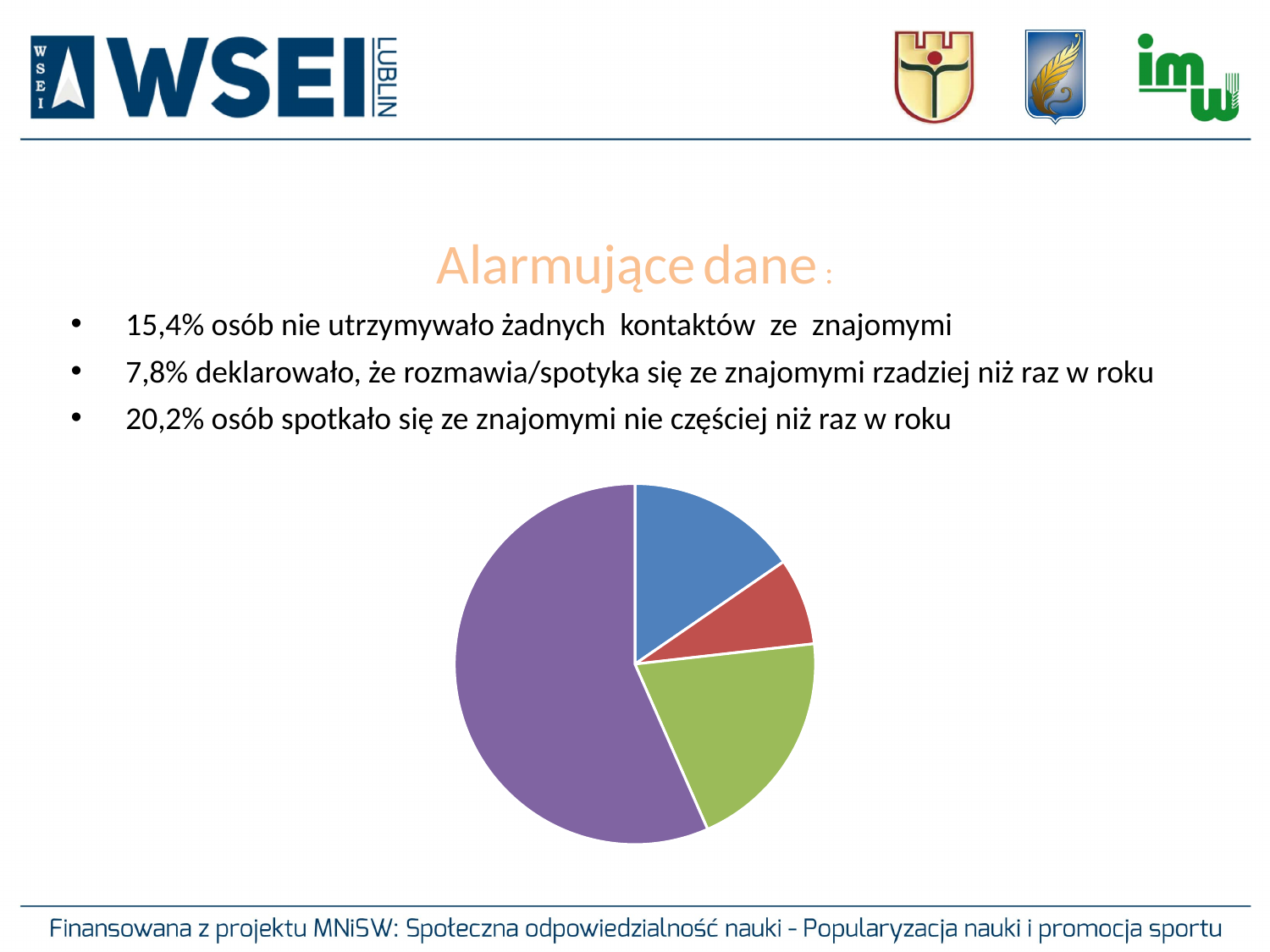
Which colour slice is the smallest in the pie chart? red Which slice is larger in the pie chart, the blue one or the green one? green Which colour slice is the largest in the pie chart? purple Is the purple slice greater or less than half of the pie? greater Which slice is larger in the pie chart, the purple one or the green one? purple What kind of chart is shown on the slide? pie chart How many slices does the pie chart have? 4 What is the title shown above the chart on the slide? Alarmujące dane